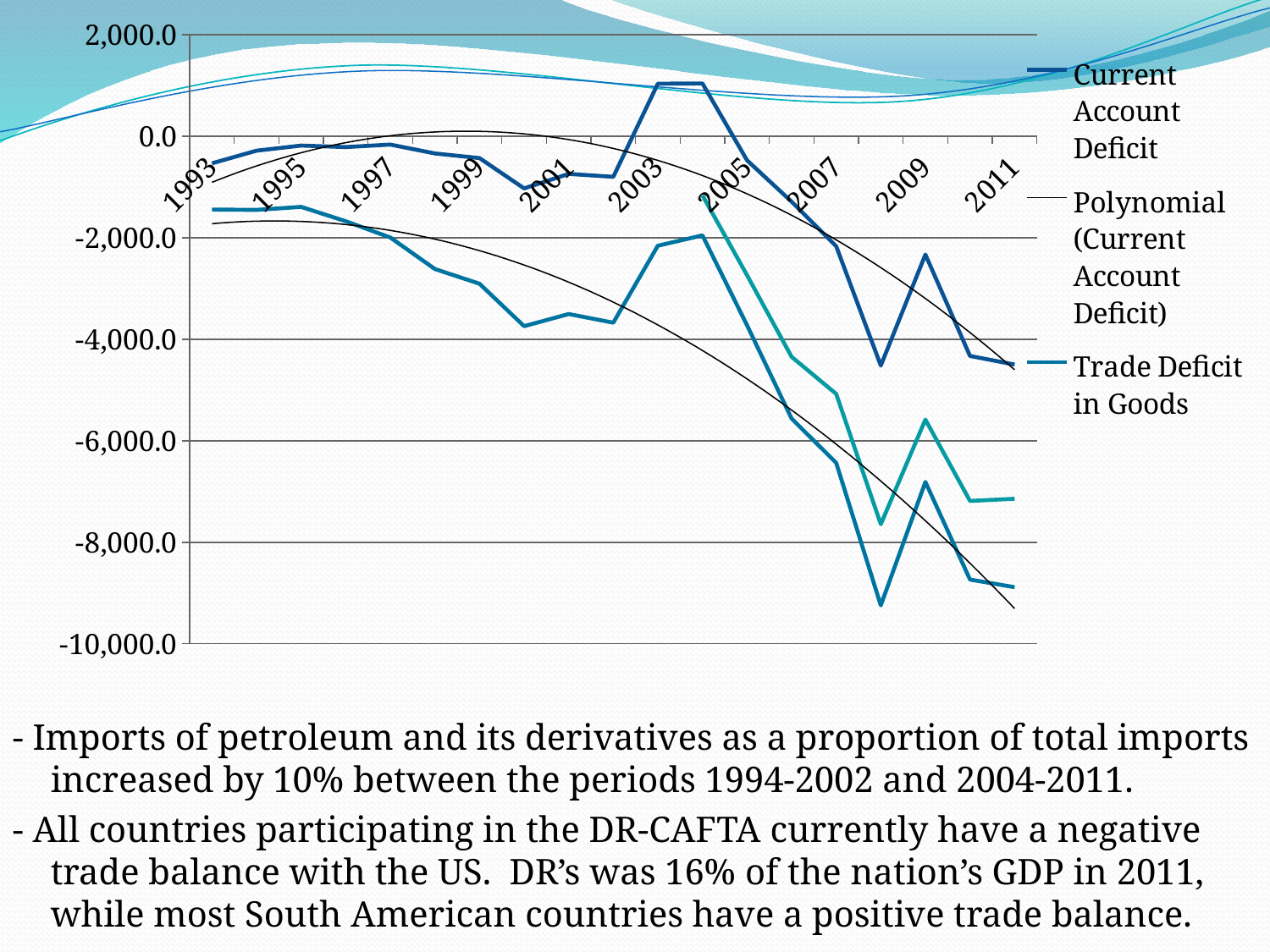
Is the value of Trade Deficit in Goods in 1993 greater or less than -2,000.0? greater Is the value of Current Account Deficit in 2003 greater or less than 0.0? greater Is the value of Current Account Deficit in 2009 greater or less than -4,000.0? greater In 2009, which series has the higher value, Current Account Deficit or Trade Deficit in Goods? Current Account Deficit How many series does the legend list? 3 What kind of chart is shown on the slide? line chart What is the lowest value shown on the vertical axis? -10,000.0 Overall, does Trade Deficit in Goods rise or fall from 1993 to 2011? fall In which year does Trade Deficit in Goods reach its lowest value? 2008 Which legend entry is listed second? Polynomial (Current Account Deficit)